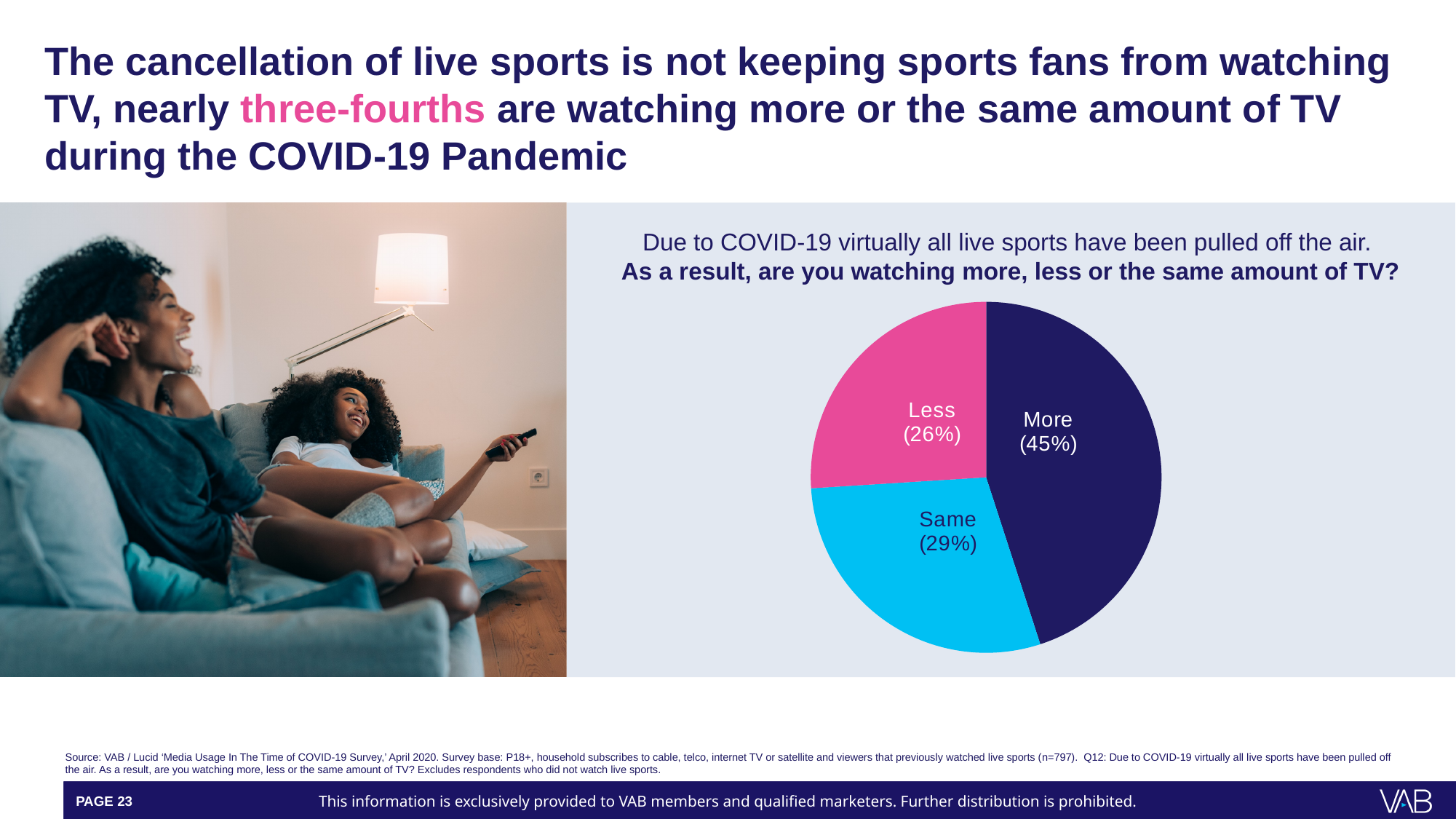
What percentage of respondents say they are watching the same amount of TV? 29% What is the difference in percentage points between the 'More' and 'Less' slices? 19 What colour is the 'Less' slice of the pie chart? Pink What percentage of respondents say they are watching more TV? 45% How many slices does the pie chart have? 3 What percentage of respondents say they are watching less TV? 26% Which response has the smallest share of the pie? Less What kind of chart is shown on the slide? Pie chart Which slice is larger, 'Same' or 'Less'? Same What is the combined share of respondents watching more or the same amount of TV? 74% What colour is the 'Same' slice of the pie chart? Light blue Which response has the largest share of the pie? More